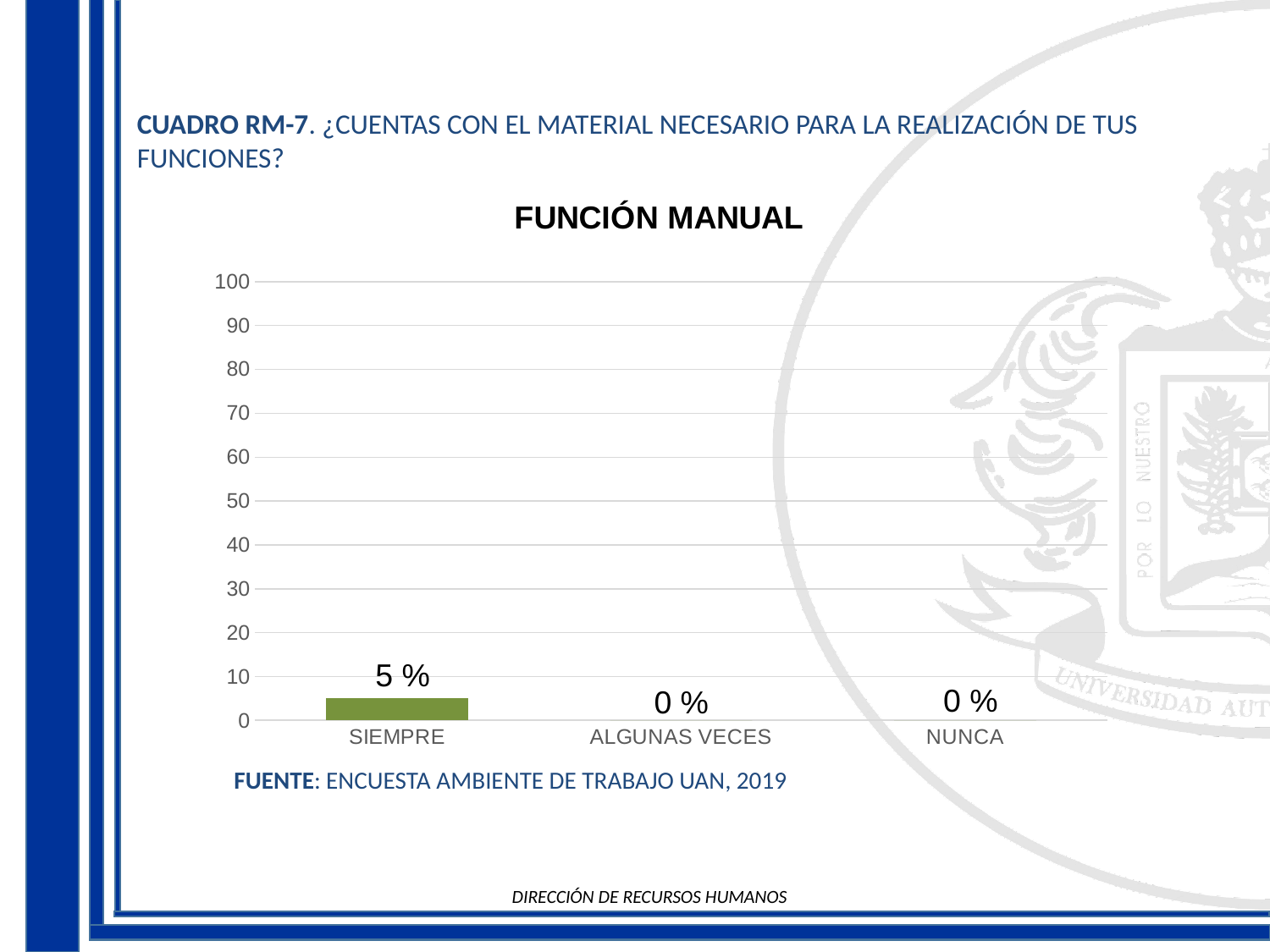
Which category has the highest value? SIEMPRE What is the value for ALGUNAS VECES? 0 % What is the value for SIEMPRE? 5 % What is the difference between the values for SIEMPRE and ALGUNAS VECES? 5 % What kind of chart is shown? bar chart What is the maximum value shown on the y axis? 100 Which is larger, the value for SIEMPRE or the value for NUNCA? SIEMPRE What is the title of the chart? FUNCIÓN MANUAL Is the value for SIEMPRE greater or less than 10? less Do the values rise or fall from SIEMPRE to NUNCA along the x axis? fall How many categories are shown on the x axis? 3 What is the value for NUNCA? 0 %